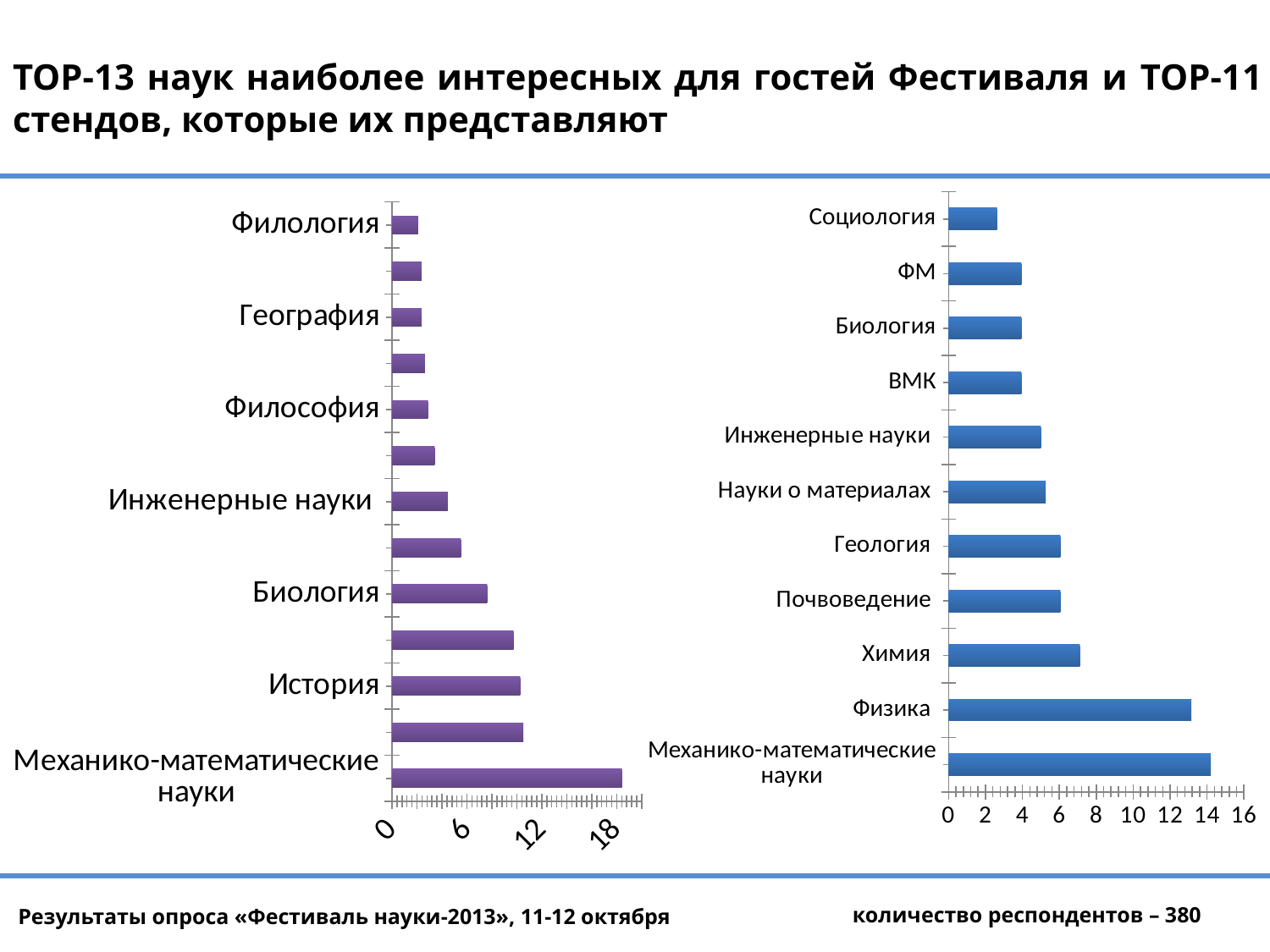
In the right chart, is the value for Социология greater or less than 4? less What kind of chart is the left chart on the slide? bar chart In the right chart, which category has the highest value? Механико-математические науки How many bars does the right chart (blue bars) have? 11 In the right chart, which category has the lowest value? Социология How many bars does the left chart (purple bars) have? 13 In the right chart, which is larger, Физика or Химия? Физика In the left chart, which is larger, История or Инженерные науки? История In the left chart, which category has the highest value? Механико-математические науки In the right chart, is the value for Физика greater or less than 12? greater In the right chart, is the value for Химия greater or less than 6? greater